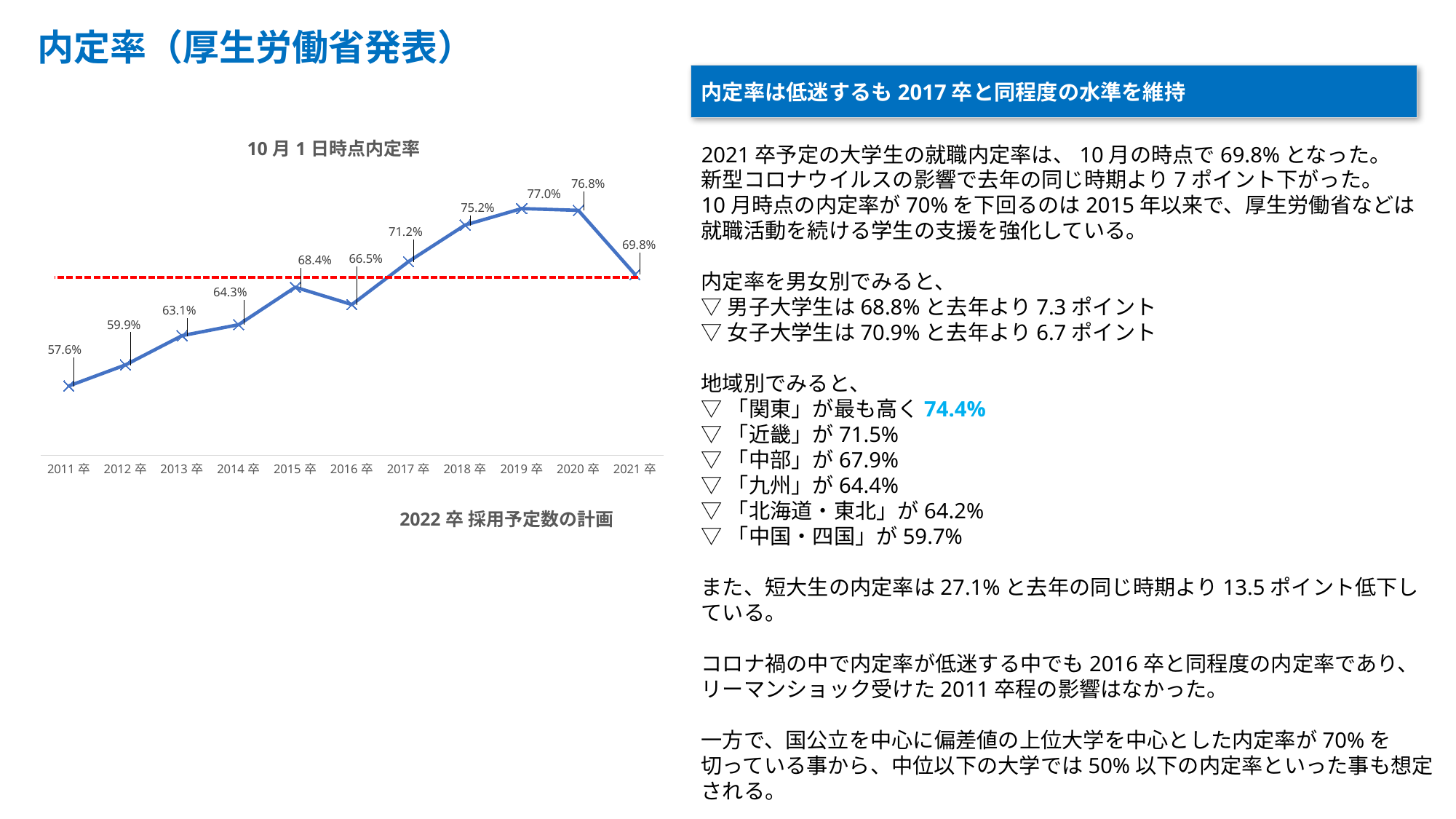
What type of chart is shown under the title 10月1日時点内定率? line chart What colour is the dashed horizontal reference line in the 10月1日時点内定率 chart? red What is the difference between the values for 2019卒 and 2011卒 in the 10月1日時点内定率 chart? 19.4% Which is larger in the 10月1日時点内定率 chart, the value for 2015卒 or 2016卒? 2015卒 Which year has the highest value in the 10月1日時点内定率 chart? 2019卒 What is the value for 2021卒 in the 10月1日時点内定率 chart? 69.8% How many years are plotted in the 10月1日時点内定率 chart? 11 What is the difference between the values for 2020卒 and 2021卒 in the 10月1日時点内定率 chart? 7.0% What is the value for 2011卒 in the 10月1日時点内定率 chart? 57.6% What is the value for 2016卒 in the 10月1日時点内定率 chart? 66.5% Which year has the lowest value in the 10月1日時点内定率 chart? 2011卒 Does the value in the 10月1日時点内定率 chart rise or fall from 2011卒 to 2015卒? rise